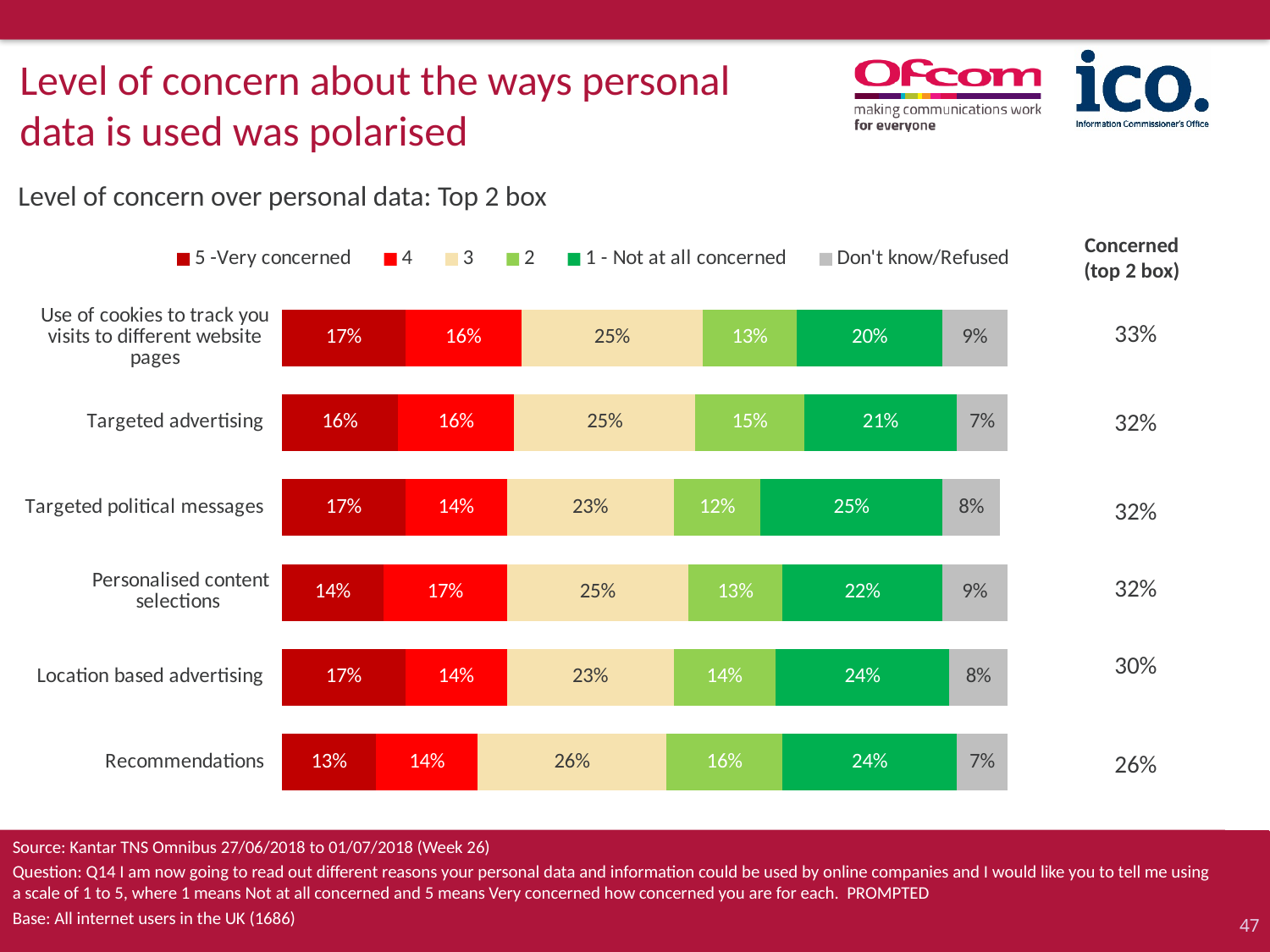
Which category has the highest value for the '3' rating? Recommendations Which has a larger value for the '2' rating: Targeted advertising or Location based advertising? Targeted advertising What is the 'Concerned (top 2 box)' figure for Use of cookies to track you visits to different website pages? 33% What type of chart is shown on the slide? Stacked bar chart What is the total of the printed segment values in the Targeted political messages bar? 99% What percentage of respondents were '5 -Very concerned' about Targeted advertising? 16% What is the 'Don't know/Refused' value for Recommendations? 7% What is the difference between the '1 - Not at all concerned' values for Recommendations and Use of cookies to track you visits to different website pages? 4 percentage points What is the '1 - Not at all concerned' value for Targeted political messages? 25% Which category has the lowest '5 -Very concerned' value? Recommendations How many series does the legend list? 6 How many categories are shown in the chart? 6